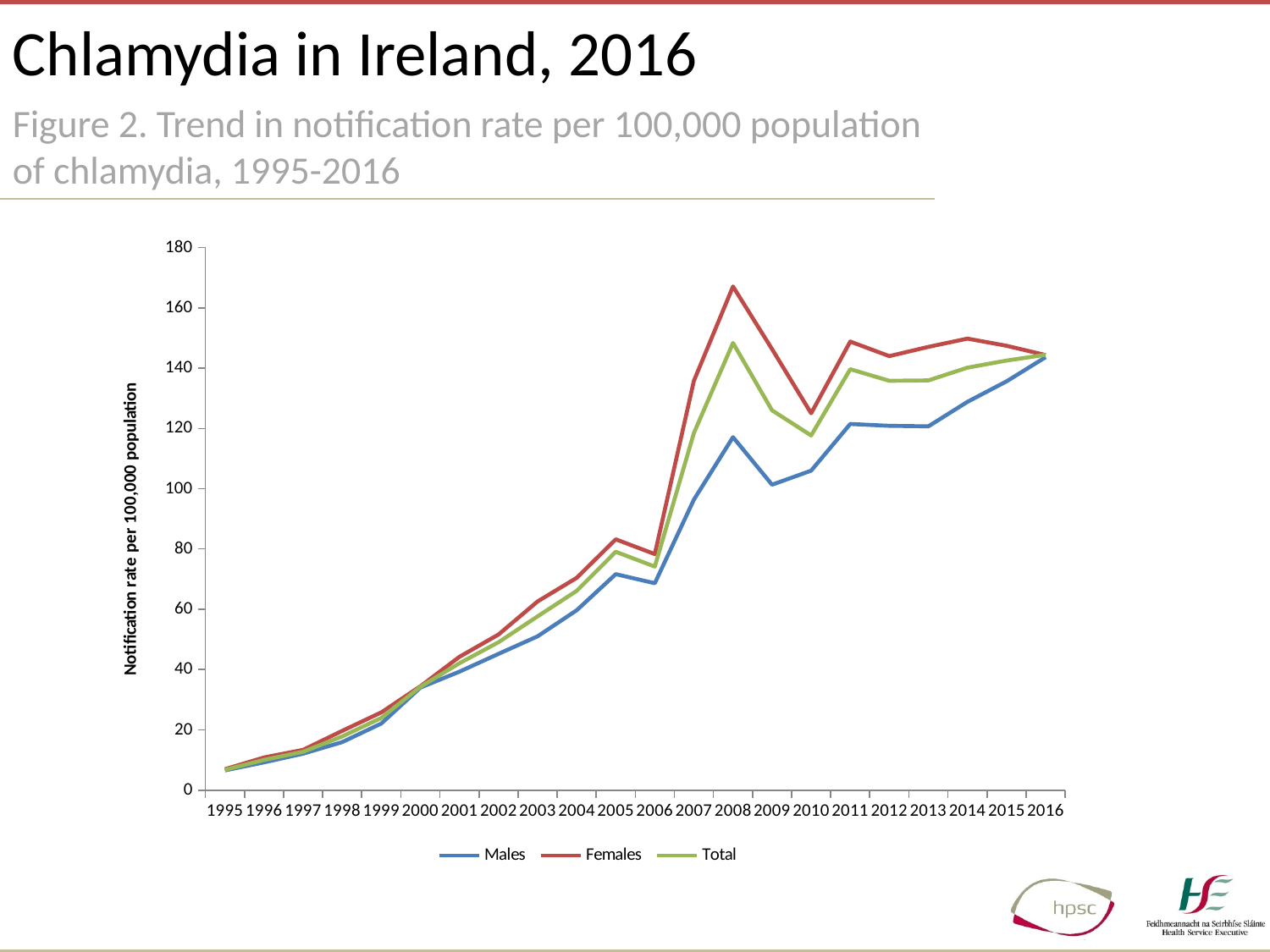
Is the value for Males in 2000 greater or less than 40? less How many series does the legend list? 3 For the Females series, which year has the larger value, 2010 or 2011? 2011 What kind of chart is shown on the slide? line chart In which year does the Females series reach its highest value? 2008 Does the Males series rise or fall from 1995 to 2005? rise Is the value for Males in 2009 greater or less than 120? less How many years are plotted along the x axis? 22 In 2008, which series has the larger value, Males or Females? Females What is the label on the y axis? Notification rate per 100,000 population Is the value for Females in 2008 greater or less than 160? greater In which year is the Females series at its lowest value? 1995